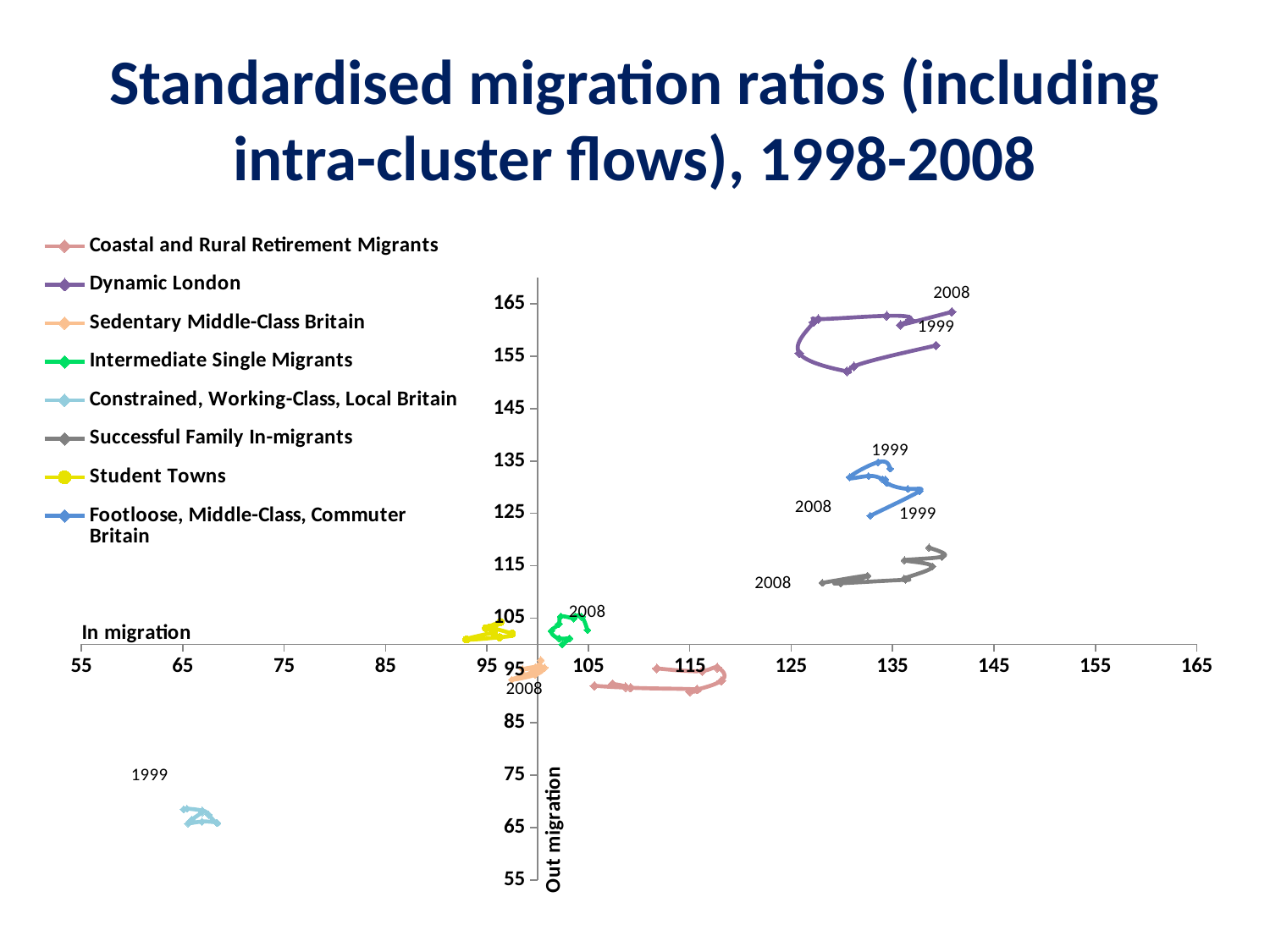
Are the out migration values for Successful Family In-migrants greater or less than 105? greater Which series has the highest out migration values? Dynamic London Are the out migration values for Coastal and Rural Retirement Migrants greater or less than 105? less What is the label of the vertical axis? Out migration What is the label of the horizontal axis? In migration Are the out migration values for Dynamic London greater or less than 145? greater Which series has higher out migration values, Dynamic London or Footloose, Middle-Class, Commuter Britain? Dynamic London What kind of chart is shown on the slide? scatter chart How many series does the legend list? 8 Which series has the lowest in migration values? Constrained, Working-Class, Local Britain